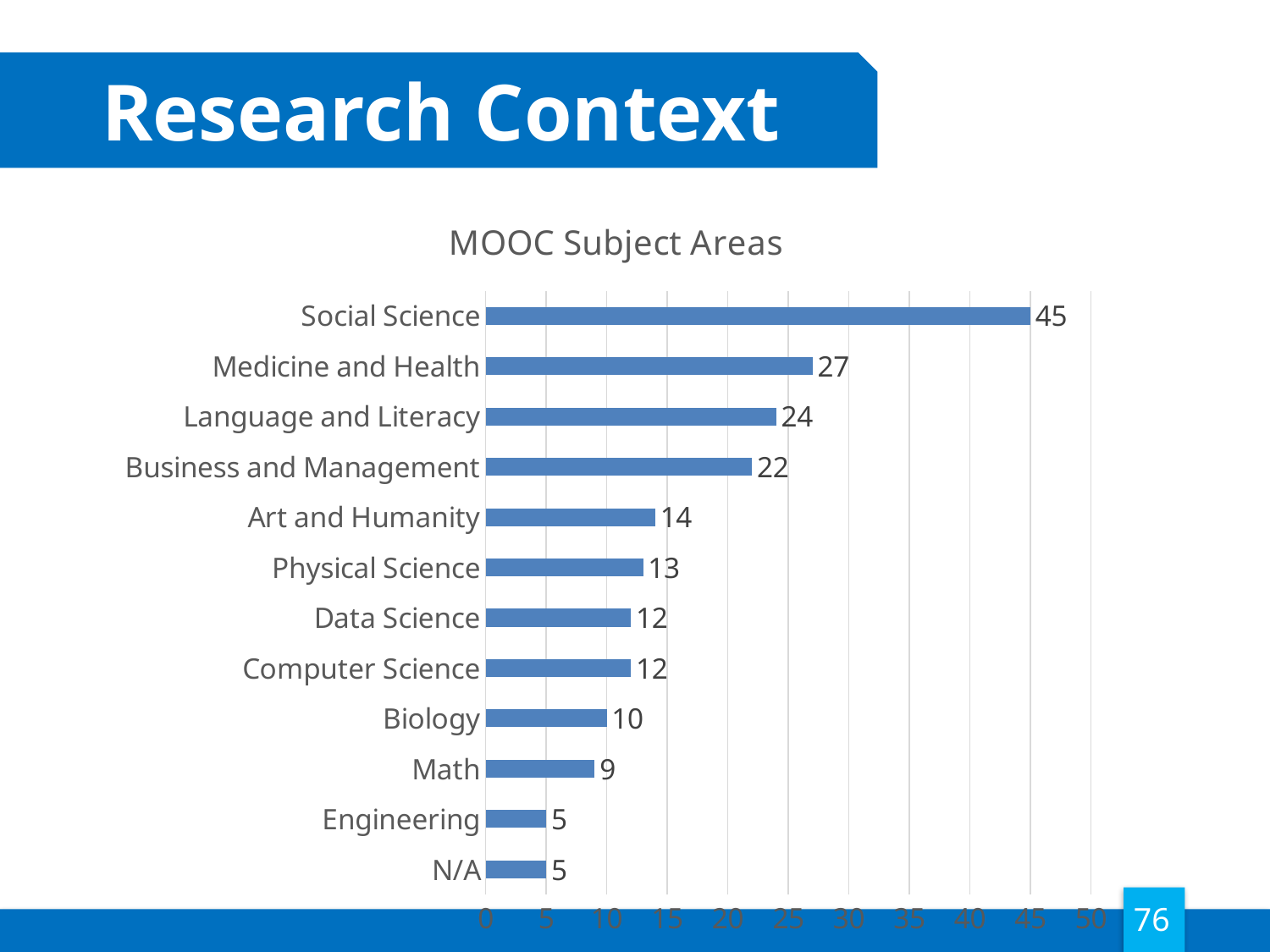
Which subject area has the highest value? Social Science Which subject area has the lowest value, other than N/A? Engineering How many subject areas are shown in the chart? 12 Which is larger, the value for Physical Science or the value for Math? Physical Science What is the difference between the values for Social Science and Medicine and Health? 18 What is the value for Social Science in the MOOC Subject Areas chart? 45 What is the value for Business and Management? 22 What is the difference between the values for Language and Literacy and Art and Humanity? 10 What is the value for Biology? 10 What kind of chart is shown on the slide? Bar chart What is the title of the chart? MOOC Subject Areas Is the value for Medicine and Health greater or less than 25? greater